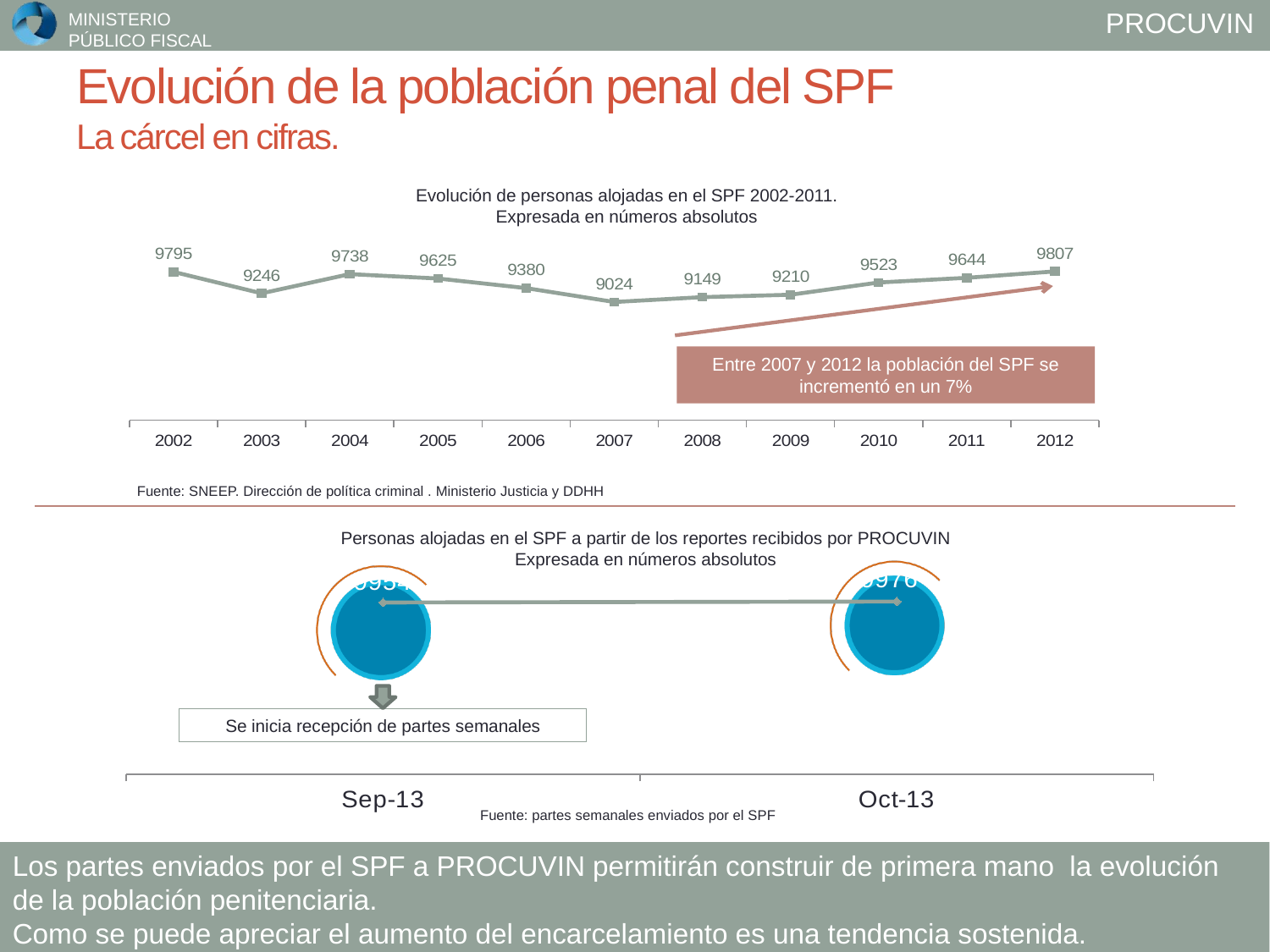
In the top chart 'Evolución de personas alojadas en el SPF 2002-2011', what is the value for 2012? 9807 In the top chart 'Evolución de personas alojadas en el SPF 2002-2011', how many years are plotted on the x axis? 11 In the top chart 'Evolución de personas alojadas en el SPF 2002-2011', which year has the lowest value? 2007 In the top chart 'Evolución de personas alojadas en el SPF 2002-2011', what is the difference between the values for 2012 and 2007? 783 What kind of chart is the top chart 'Evolución de personas alojadas en el SPF 2002-2011'? line chart In the bottom chart 'Personas alojadas en el SPF a partir de los reportes recibidos por PROCUVIN', how many points are plotted? 2 In the top chart 'Evolución de personas alojadas en el SPF 2002-2011', which year has the highest value? 2012 According to the annotation on the top chart, by what percentage did the SPF population increase between 2007 and 2012? 7% In the top chart 'Evolución de personas alojadas en el SPF 2002-2011', do the values rise or fall from 2007 to 2012? rise In the top chart 'Evolución de personas alojadas en el SPF 2002-2011', what is the value for 2003? 9246 In the top chart 'Evolución de personas alojadas en el SPF 2002-2011', what is the value for 2007? 9024 In the top chart 'Evolución de personas alojadas en el SPF 2002-2011', which is larger, the value for 2004 or the value for 2005? 2004